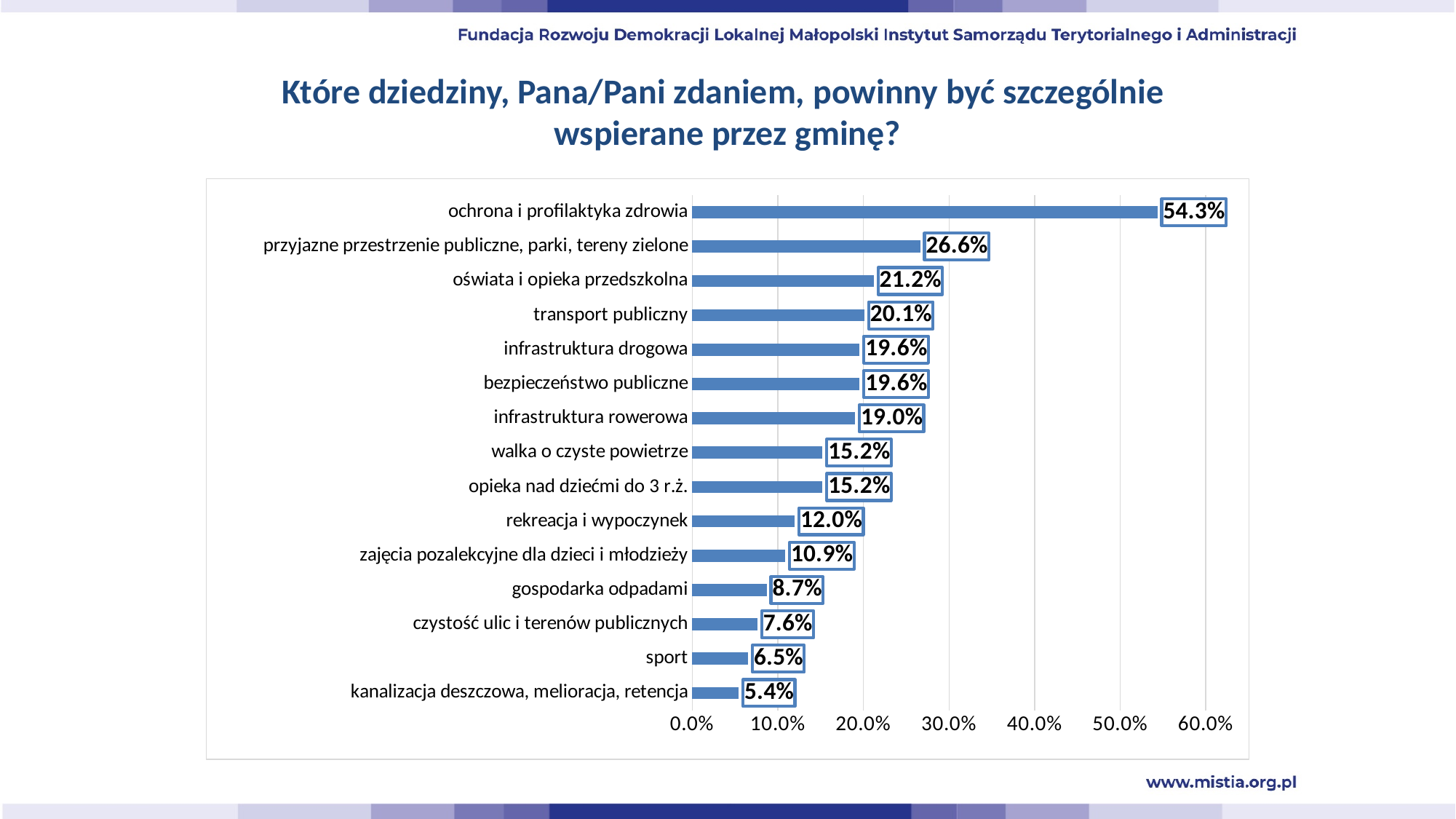
Which category has the highest value? ochrona i profilaktyka zdrowia What is the difference between "ochrona i profilaktyka zdrowia" and "przyjazne przestrzenie publiczne, parki, tereny zielone"? 27.7% What is the value for "transport publiczny"? 20.1% Which is larger: "rekreacja i wypoczynek" or "sport"? rekreacja i wypoczynek Which category has the lowest value? kanalizacja deszczowa, melioracja, retencja Is the value for "oświata i opieka przedszkolna" greater or less than 20.0%? greater What is the title of the chart on the slide? Które dziedziny, Pana/Pani zdaniem, powinny być szczególnie wspierane przez gminę? What is the value for "ochrona i profilaktyka zdrowia"? 54.3% How many categories are shown in the chart? 15 What is the value for "kanalizacja deszczowa, melioracja, retencja"? 5.4% What is the value for "gospodarka odpadami"? 8.7% What kind of chart is shown on the slide? bar chart